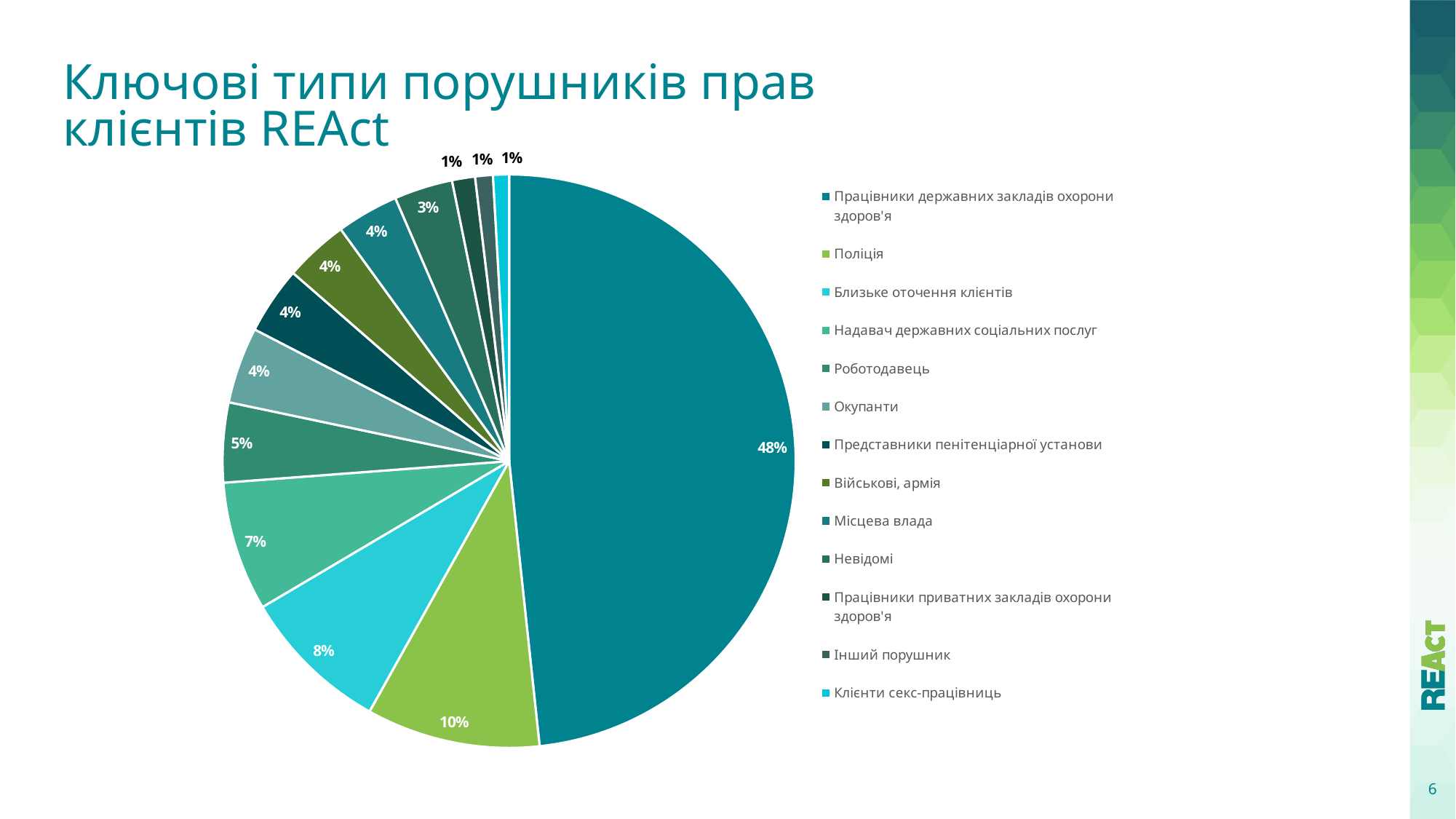
Which is larger, the share for Роботодавець or the share for Надавач державних соціальних послуг? Надавач державних соціальних послуг What is the title of the slide? Ключові типи порушників прав клієнтів REAct What kind of chart is shown on the slide? Pie chart Which category has the largest slice of the pie? Працівники державних закладів охорони здоров'я What percentage is shown for Близьке оточення клієнтів? 8% What percentage is shown for Надавач державних соціальних послуг? 7% What percentage is shown for Роботодавець? 5% What is the difference in percentage points between Поліція and Близьке оточення клієнтів? 2% What percentage is shown for Невідомі? 3% What percentage is shown for Поліція? 10% What share of the pie is labelled for Працівники державних закладів охорони здоров'я? 48% How many categories does the legend list? 13